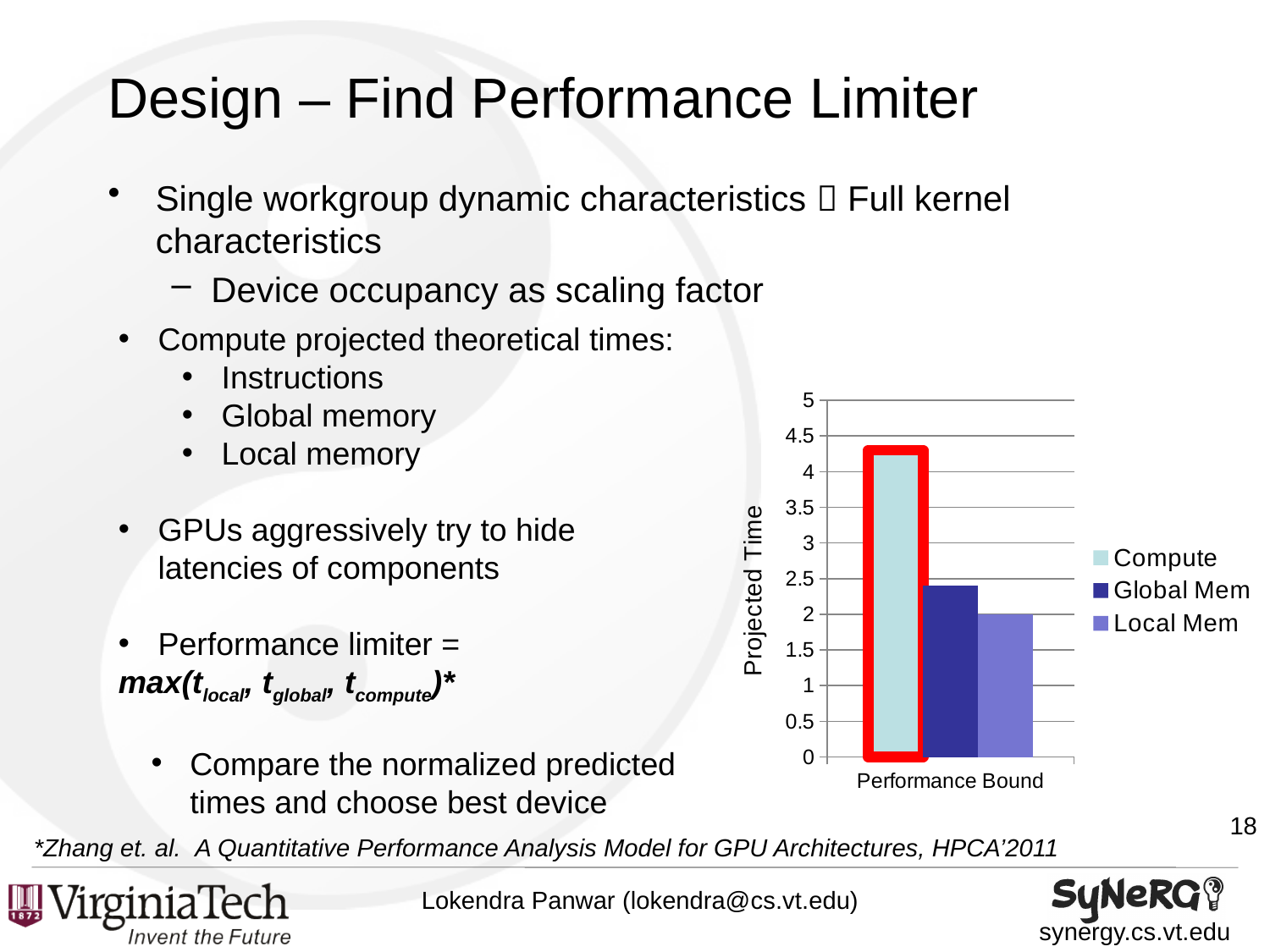
What is the label on the y axis of the chart? Projected Time How many categories are shown on the x axis? 1 How many series does the legend list? 3 Is the projected time for Compute greater or less than 4? greater Which series has the lowest projected time? Local Mem What is the projected time for Local Mem? 2 Which series has the highest projected time? Compute What kind of chart is shown on the slide? bar chart Is the projected time for Global Mem greater or less than 3? less What is the category label on the x axis of the chart? Performance Bound Which is larger, the projected time for Compute or for Global Mem? Compute Which is larger, the projected time for Global Mem or for Local Mem? Global Mem